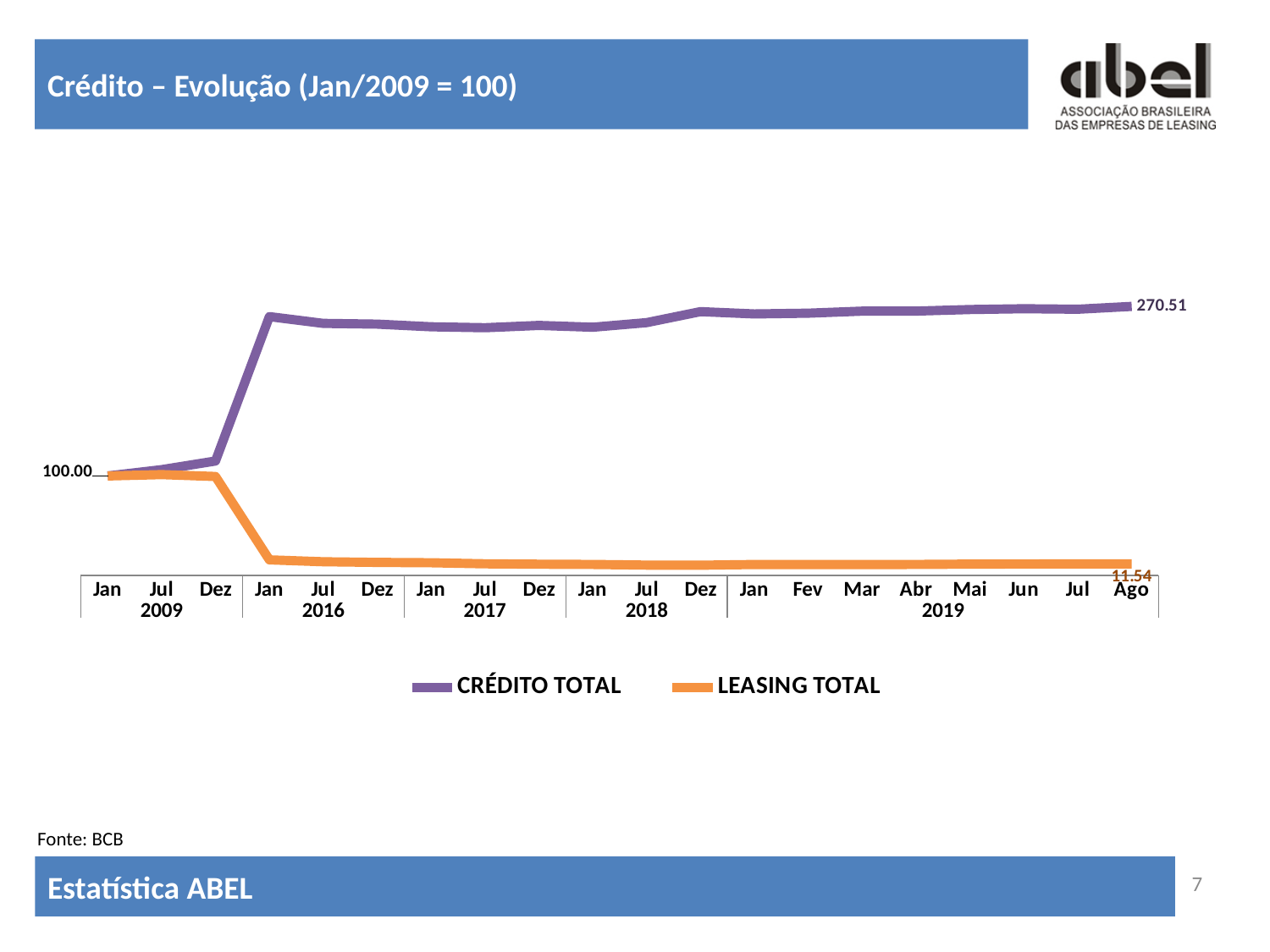
Which series has the higher value in Ago 2019, CRÉDITO TOTAL or LEASING TOTAL? CRÉDITO TOTAL Does the CRÉDITO TOTAL series rise or fall from Jan 2009 to Ago 2019? rise What is the starting value of both series in Jan 2009? 100.00 How many labelled points are on the x axis? 20 By how much did CRÉDITO TOTAL increase from Jan 2009 (100.00) to Ago 2019? 170.51 How many series does the legend list? 2 What is the value of CRÉDITO TOTAL in Ago 2019? 270.51 Does the LEASING TOTAL series rise or fall from Jan 2009 to Ago 2019? fall What is the title of the chart? Crédito – Evolução (Jan/2009 = 100) What kind of chart is shown on the slide? line chart What is the value of LEASING TOTAL in Ago 2019? 11.54 What is the difference between CRÉDITO TOTAL and LEASING TOTAL in Ago 2019? 258.97